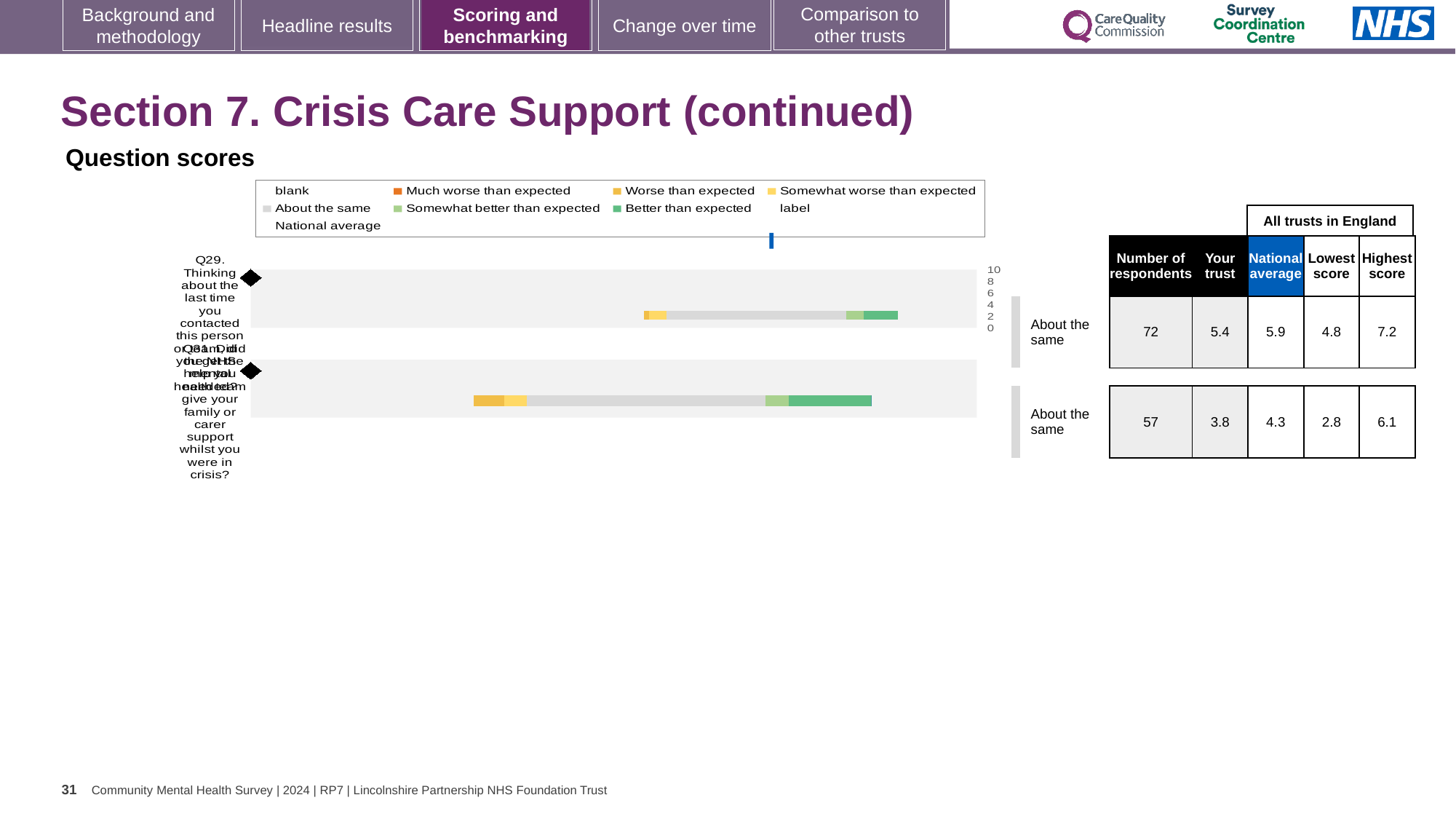
In the table beside the chart, what is the number of respondents for Q29? 72 In the chart legend, what colour represents 'Much worse than expected'? orange For Q29, which is larger: the 'Your trust' score or the national average? National average In the table beside the chart, what is the 'Your trust' score for Q31? 3.8 In the chart legend, what colour represents 'Better than expected'? green What kind of chart is shown under 'Question scores'? bar chart For Q31, what is the difference between the highest score and the lowest score? 3.3 Which question has the higher number of respondents, Q29 or Q31? Q29 How many question bars are plotted in the chart? 2 What is the difference between the 'Your trust' scores for Q29 and Q31? 1.6 In the table beside the chart, what is the national average for Q29? 5.9 In the table beside the chart, what is the lowest score for Q29? 4.8